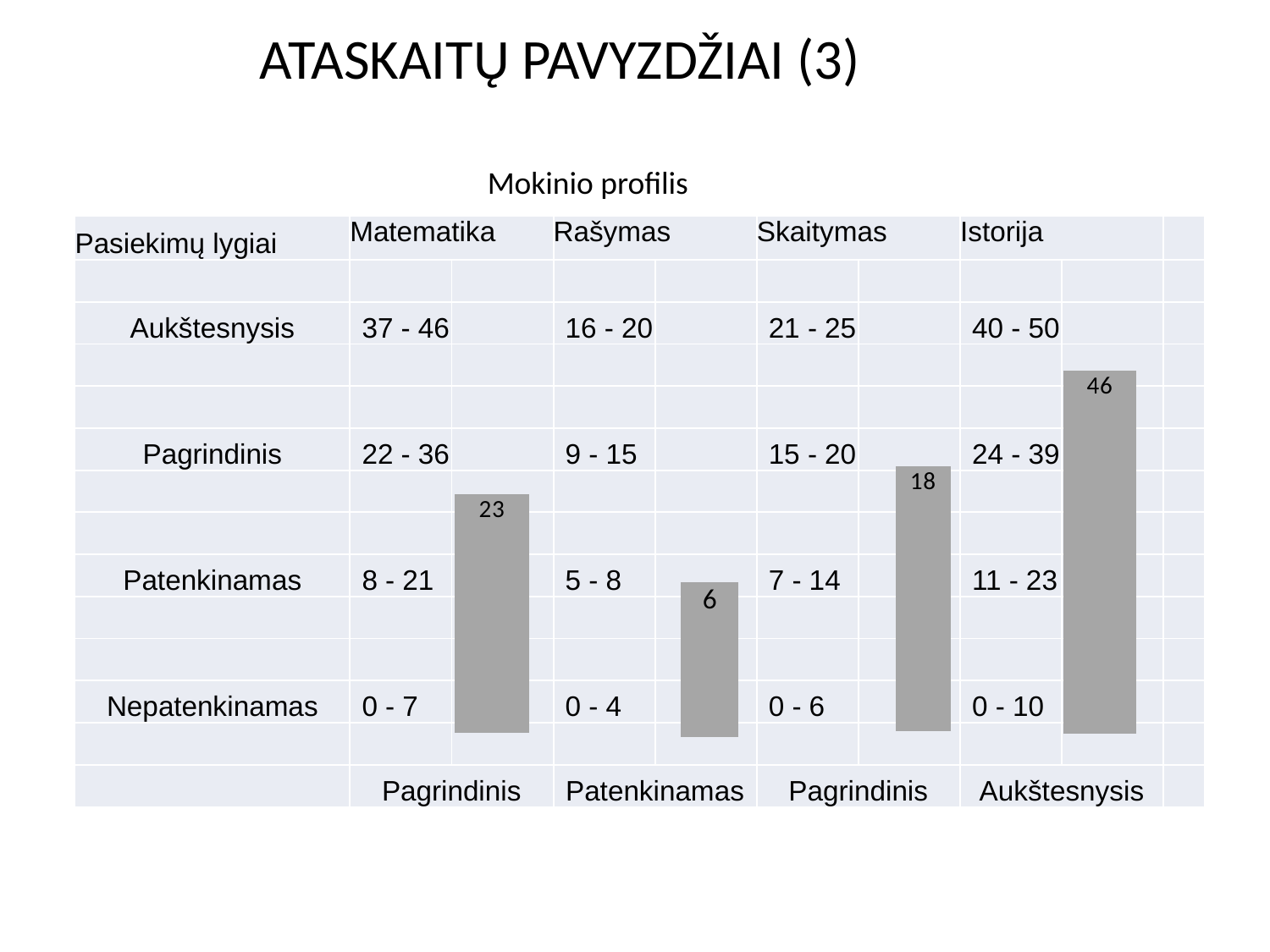
What is the value of the bar for Skaitymas in the Mokinio profilis chart? 18 What is the value of the bar for Matematika in the Mokinio profilis chart? 23 What is the difference between the Istorija and Matematika bars in the Mokinio profilis chart? 23 How many bars are plotted in the Mokinio profilis chart? 4 What is the value of the bar for Rašymas in the Mokinio profilis chart? 6 Which subject has the lowest bar in the Mokinio profilis chart? Rašymas Which subject has the highest bar in the Mokinio profilis chart? Istorija What kind of chart is the Mokinio profilis chart? bar chart What is the value of the bar for Istorija in the Mokinio profilis chart? 46 What achievement level label is shown under the Istorija bar in the Mokinio profilis chart? Aukštesnysis What is the difference between the Skaitymas and Rašymas bars in the Mokinio profilis chart? 12